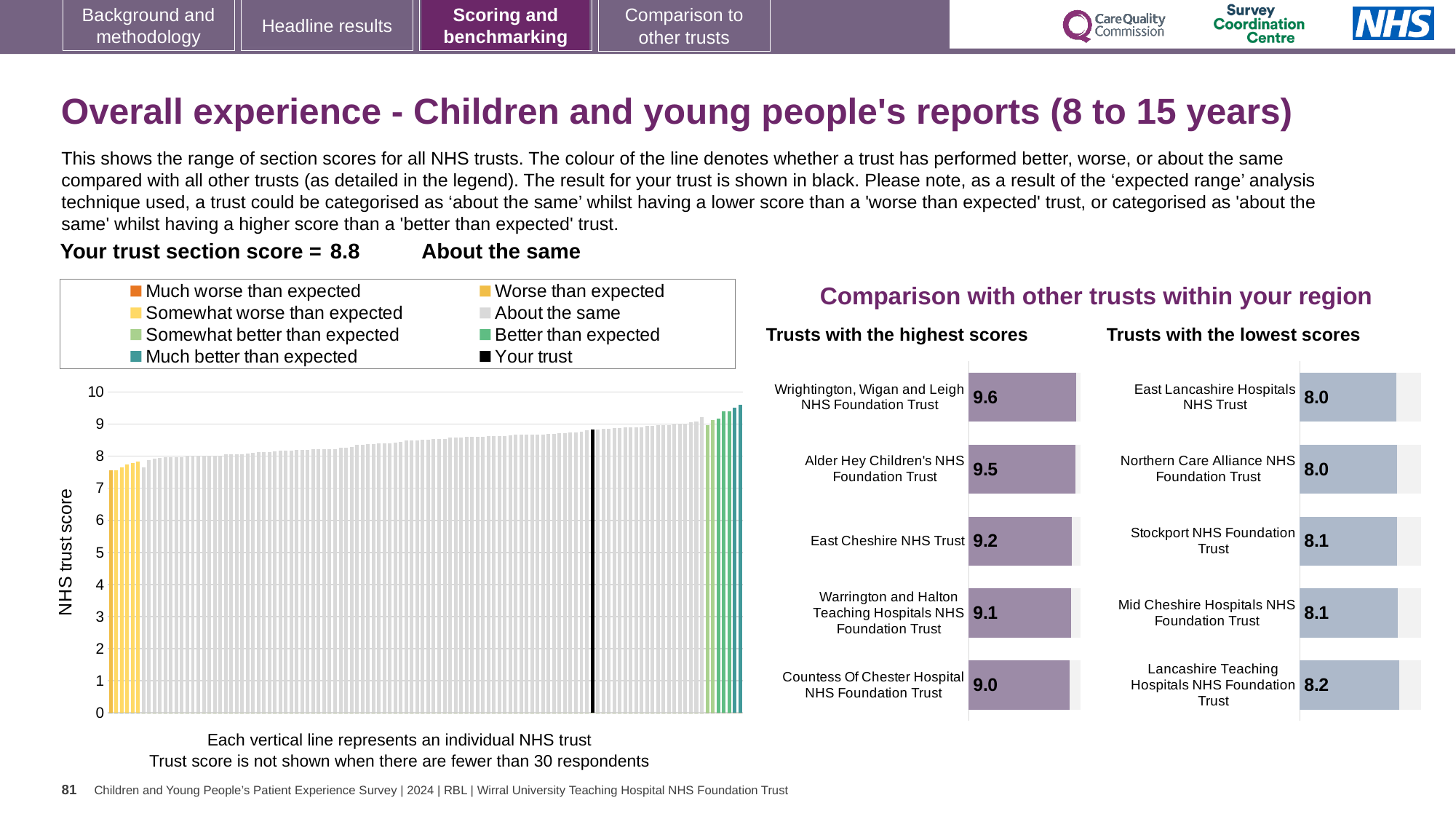
In the 'Trusts with the lowest scores' chart, which trust has the highest score? Lancashire Teaching Hospitals NHS Foundation Trust Which has the higher score: Alder Hey Children's NHS Foundation Trust in the 'highest scores' chart or Stockport NHS Foundation Trust in the 'lowest scores' chart? Alder Hey Children's NHS Foundation Trust In the 'Trusts with the highest scores' chart, what is the difference between the scores of Wrightington, Wigan and Leigh NHS Foundation Trust and Countess Of Chester Hospital NHS Foundation Trust? 0.6 In the 'Trusts with the highest scores' chart, what is the score for Countess Of Chester Hospital NHS Foundation Trust? 9.0 What kind of chart is the large chart on the left showing NHS trust scores? Bar chart In the 'Trusts with the highest scores' chart, what is the score for Wrightington, Wigan and Leigh NHS Foundation Trust? 9.6 In the 'Trusts with the lowest scores' chart, what is the score for Lancashire Teaching Hospitals NHS Foundation Trust? 8.2 How many trusts are shown in the 'Trusts with the highest scores' chart? 5 In the 'Trusts with the lowest scores' chart, what is the difference between the scores of Lancashire Teaching Hospitals NHS Foundation Trust and East Lancashire Hospitals NHS Trust? 0.2 In the 'Trusts with the highest scores' chart, which trust has the highest score? Wrightington, Wigan and Leigh NHS Foundation Trust In the large chart on the left, is the value for the black 'Your trust' bar greater or less than 8? greater How many entries does the legend of the large chart on the left list? 8